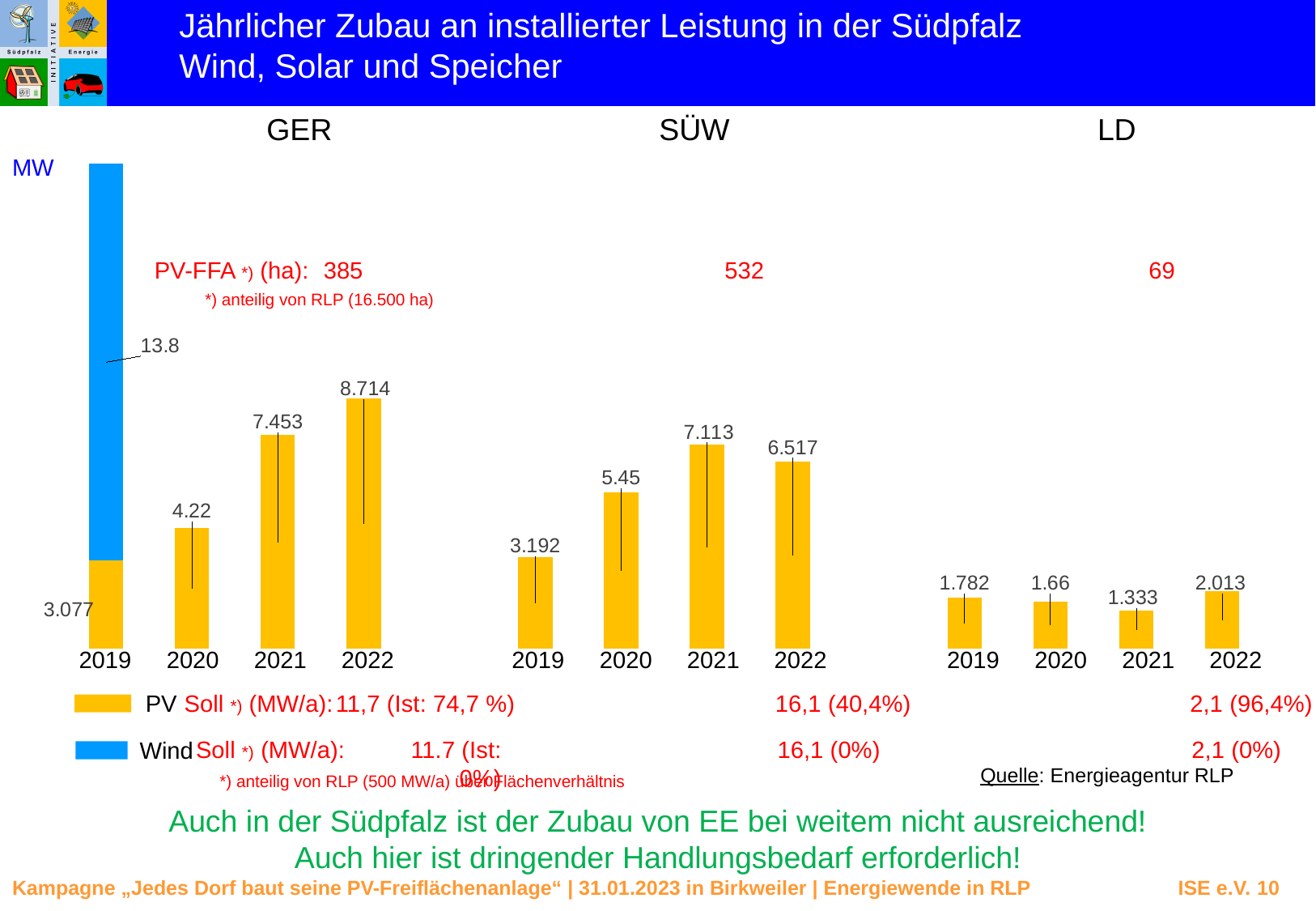
In the SÜW chart, what is the value for 2020? 5.45 In the SÜW chart, which year has the highest value? 2021 In the GER chart, what is the Wind value for 2019? 13.8 In the LD chart, which year has the lowest value? 2021 In the GER chart, what is the total of the stacked 2019 bar (PV plus Wind)? 16.877 How many years are shown on the x axis of the SÜW chart? 4 In the GER chart, what is the PV value for 2022? 8.714 In the LD chart, what is the value for 2019? 1.782 What kind of chart is used for the GER, SÜW and LD data? bar chart In the LD chart, is the value for 2022 larger or smaller than the value for 2020? larger In the SÜW chart, what is the difference between the 2021 and 2022 values? 0.596 How many series does the legend list? 2